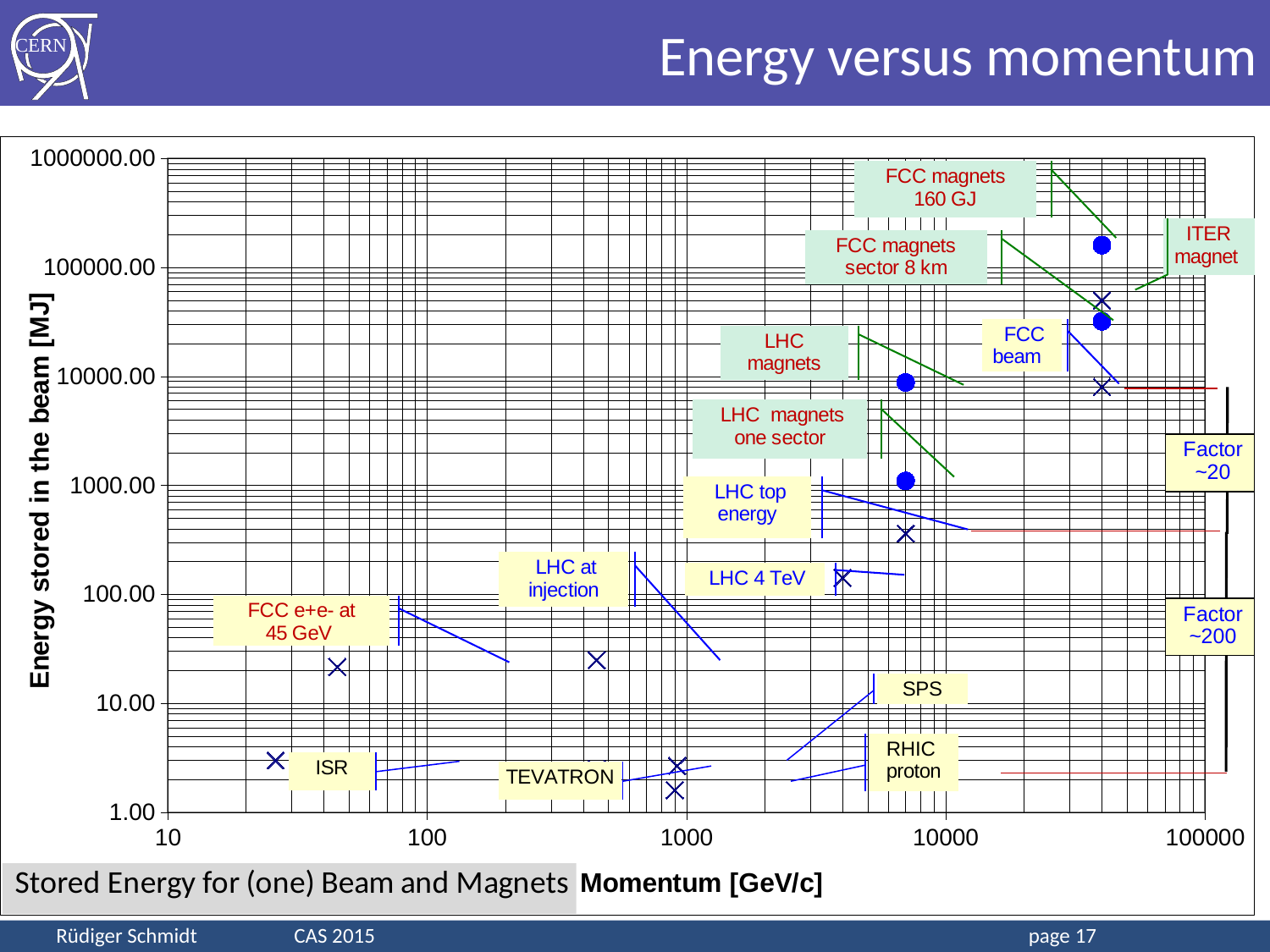
Which labelled point has the lowest stored energy in the chart? TEVATRON Is the stored energy for LHC top energy greater or less than 1000 MJ? less Is the stored energy for LHC at injection greater or less than 10 MJ? greater What is the label of the horizontal axis of the chart? Momentum [GeV/c] Which has the larger stored energy, FCC magnets or LHC magnets? FCC magnets Which labelled point has the highest stored energy in the chart? FCC magnets 160 GJ Which has the larger stored energy, LHC top energy or LHC at injection? LHC top energy Is the stored energy for ISR greater or less than 10 MJ? less What stored energy is given for the FCC magnets in the chart annotation? 160 GJ What is the label of the vertical axis of the chart? Energy stored in the beam [MJ] What kind of chart is shown on the slide? scatter chart